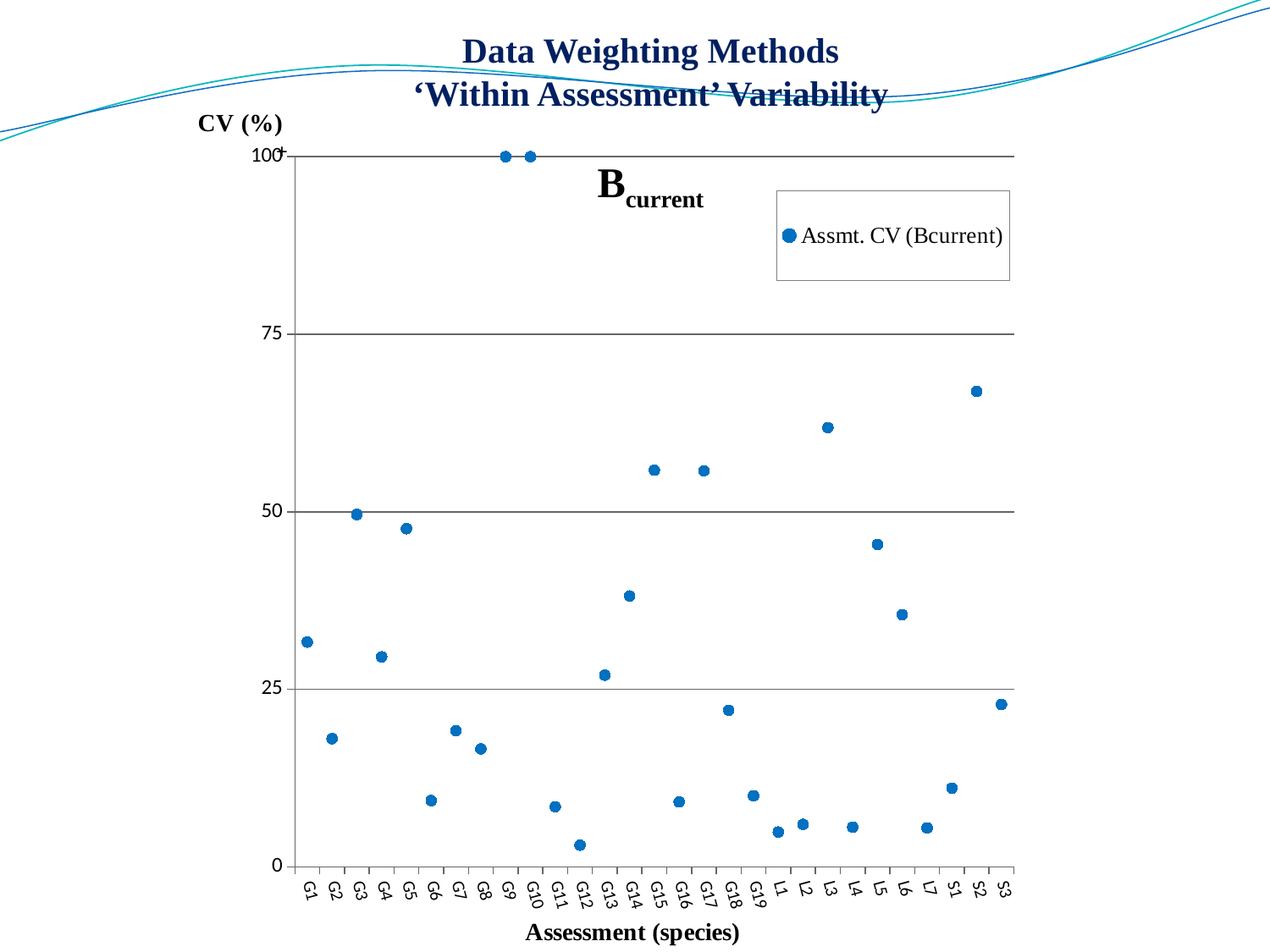
Is the value for G14 greater or less than 25? greater Is the value for S2 greater or less than 50? greater What is the legend entry for the plotted series? Assmt. CV (Bcurrent) How many series does the legend list? 1 Which has the larger CV value, G6 or L3? L3 Is the value for G12 greater or less than 25? less What is the title of the x axis? Assessment (species) How many assessments (categories) are plotted along the x axis? 29 Which has the larger CV value, S2 or G12? S2 What kind of chart is shown on the slide? scatter chart